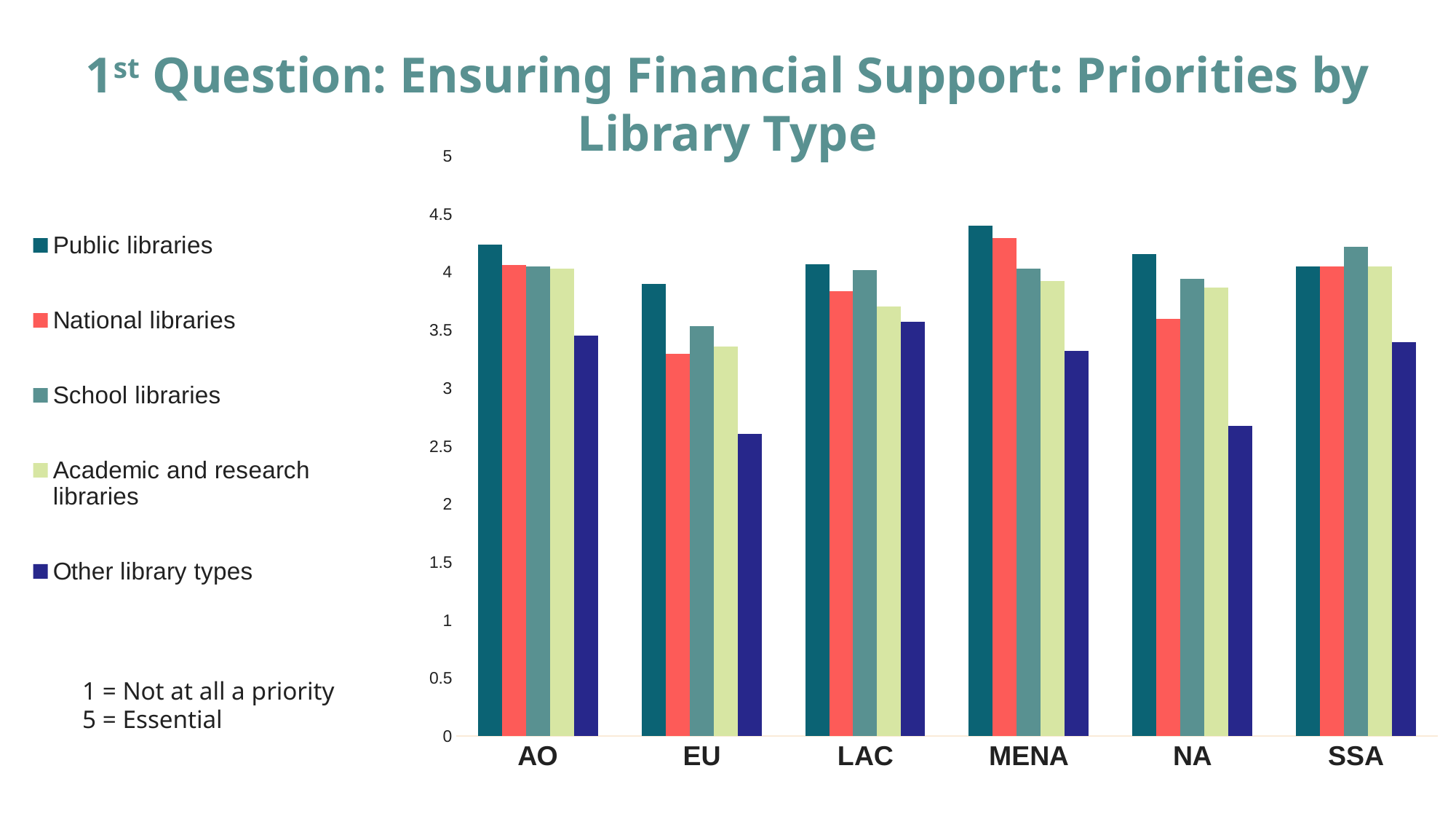
According to the scale note on the slide, what does a value of 5 mean? Essential In EU, which is larger: the value for Public libraries or National libraries? Public libraries Is the value for Other library types in NA greater or less than 3? less Is the value for Public libraries in MENA greater or less than 4? greater How many series does the legend list? 5 What kind of chart is shown on the slide? bar chart Is the value for Other library types in EU greater or less than 3? less Which region has the highest value for Public libraries? MENA How many regions are shown along the x axis? 6 Which region has the lowest value for Public libraries? EU In NA, which is larger: the value for National libraries or School libraries? School libraries